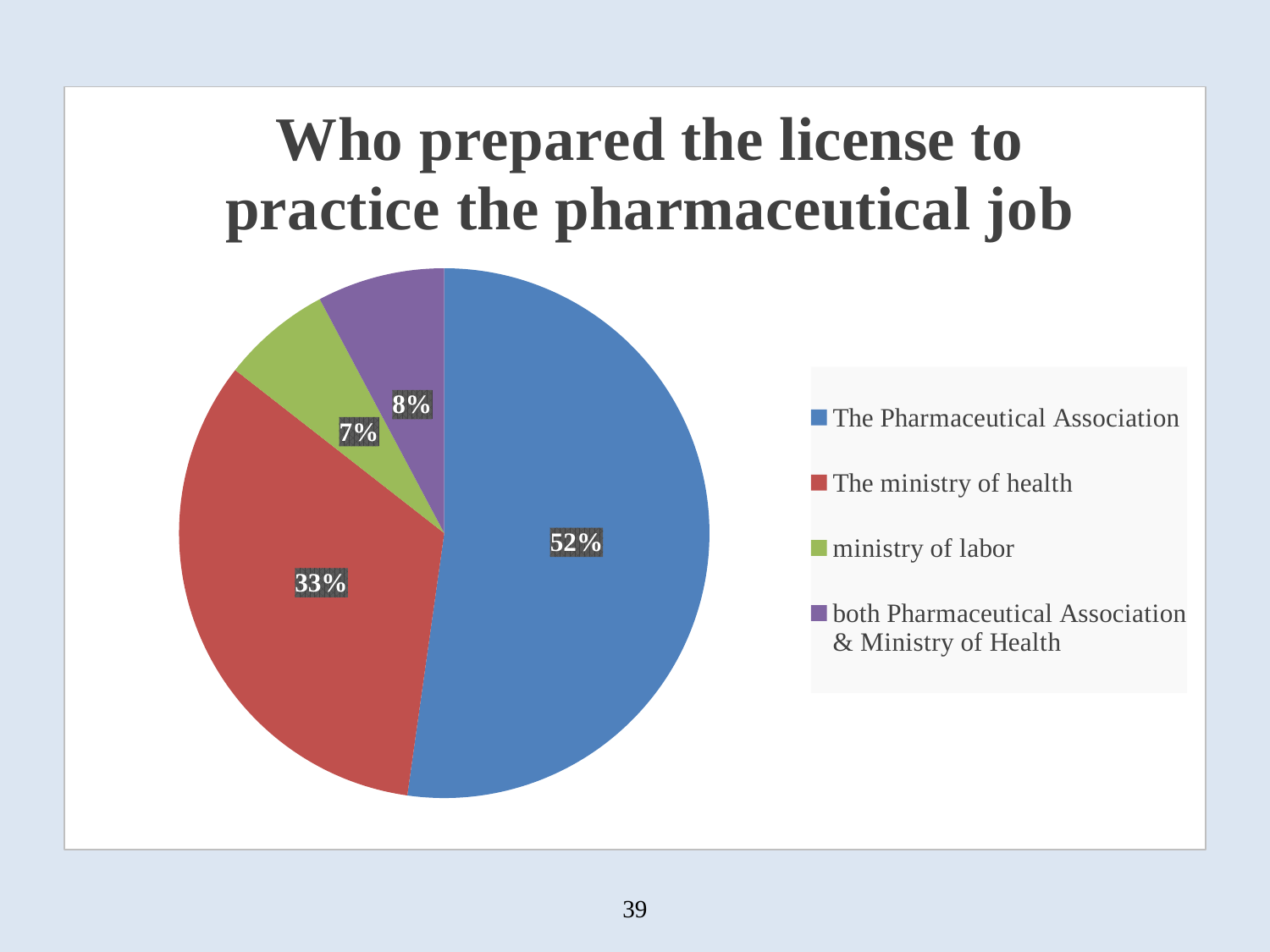
What share of the pie does The Pharmaceutical Association have? 52% What is the title of the chart? Who prepared the license to practice the pharmaceutical job What kind of chart is shown on the slide? pie chart What share of the pie does ministry of labor have? 7% What is the difference in percentage points between The Pharmaceutical Association and The ministry of health? 19 Which category has the largest slice of the pie? The Pharmaceutical Association Which is larger, the slice for The ministry of health or the slice for ministry of labor? The ministry of health What share of the pie does both Pharmaceutical Association & Ministry of Health have? 8% What colour is the slice for The ministry of health? red How many categories does the pie chart show? 4 Which category has the smallest slice of the pie? ministry of labor